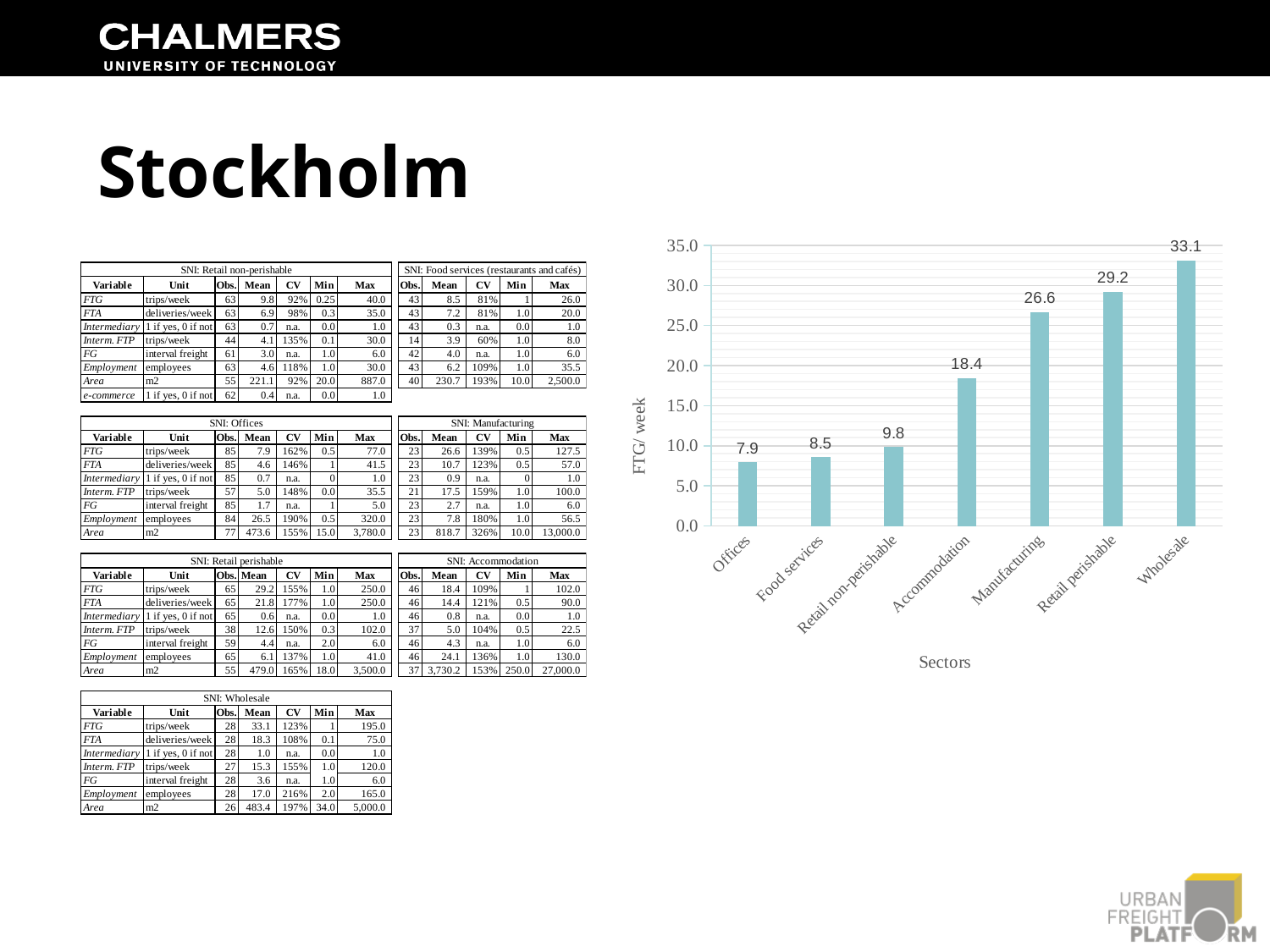
What is the FTG/week value for Accommodation? 18.4 Do the values rise or fall from left to right along the x axis? rise How many sectors are shown in the chart? 7 Is the value for Manufacturing greater or less than 25.0? greater Which sector has the lowest FTG/week? Offices What type of chart is shown on the slide? bar chart What is the FTG/week value for Wholesale? 33.1 Which sector has the highest FTG/week? Wholesale Which has a higher FTG/week, Food services or Accommodation? Accommodation What is the FTG/week value for Retail non-perishable? 9.8 What is the difference in FTG/week between Wholesale and Offices? 25.2 What is the difference in FTG/week between Retail perishable and Manufacturing? 2.6